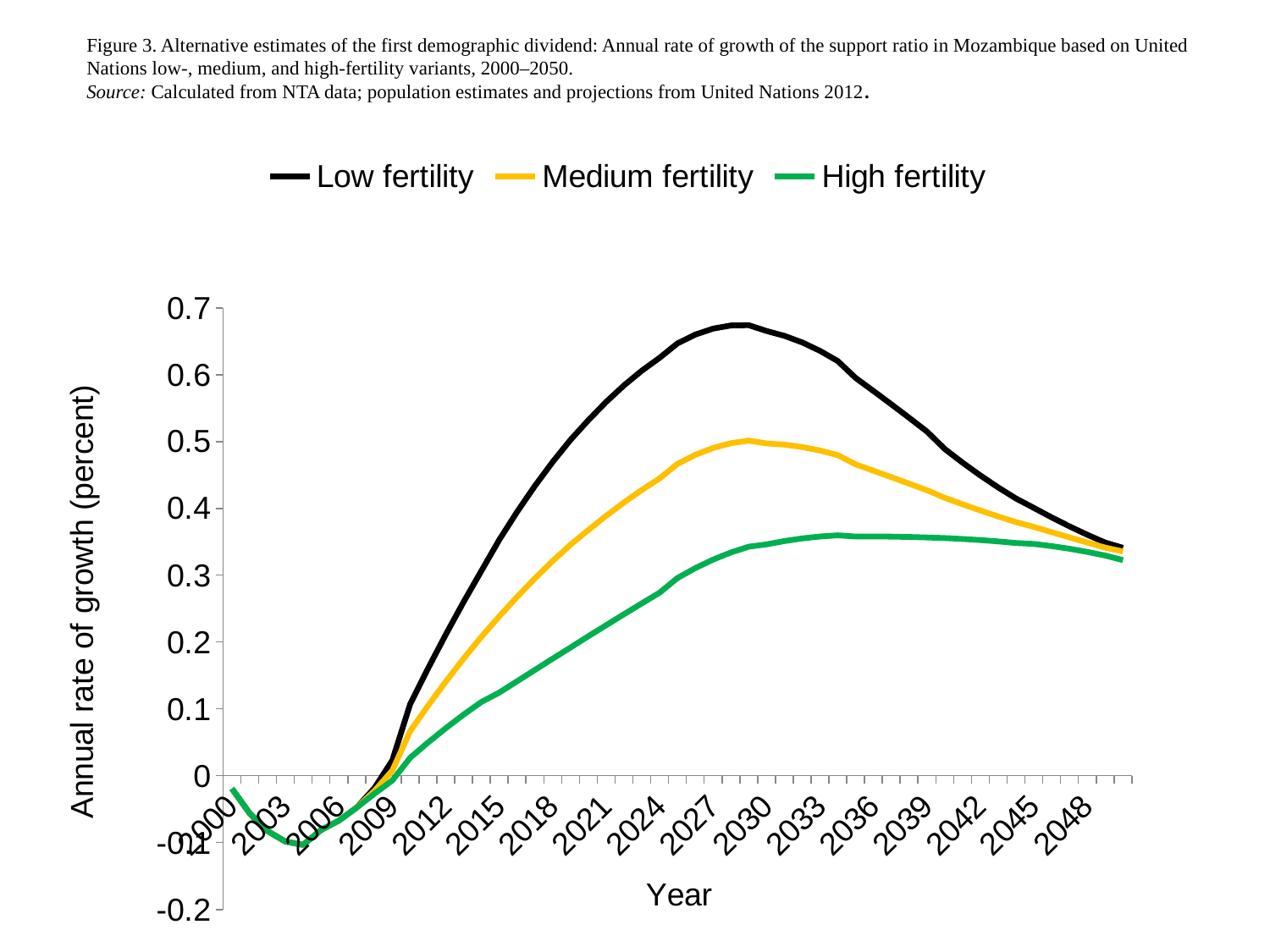
Is the value for Low fertility in 2030 greater or less than 0.6? greater What kind of chart is shown on the slide? line chart Is the value for High fertility in 2018 greater or less than 0.1? greater Is the value for High fertility in 2030 greater or less than 0.4? less Does the Low fertility line rise or fall between 2030 and 2048? fall What is the title of the vertical axis? Annual rate of growth (percent) Which colour is used for the High fertility line? green Which series reaches the highest peak value on the chart? Low fertility How many series does the legend list? 3 In 2021, which is larger: the Medium fertility value or the High fertility value? Medium fertility